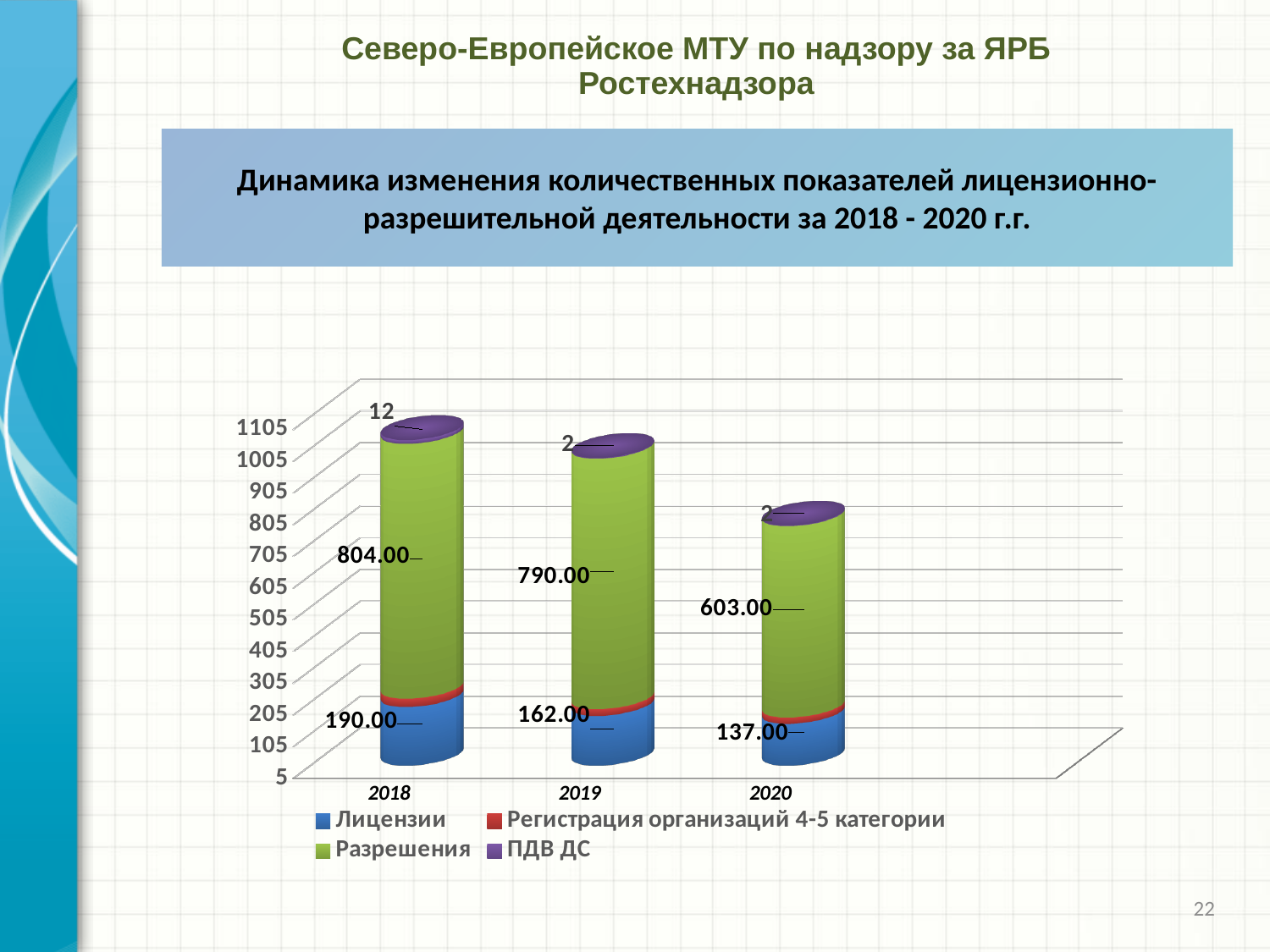
What is the difference between the Разрешения values for 2018 and 2020? 201.00 What is the value of Разрешения for 2019? 790.00 How many series does the legend list? 4 What is the value of Разрешения for 2020? 603.00 Which colour represents the Разрешения series? green In which year is the value of Разрешения highest? 2018 What is the value of ПДВ ДС for 2018? 12 What type of chart is shown on the slide? stacked bar chart Does the value of Лицензии rise or fall from 2018 to 2020? fall How many years are shown on the x axis? 3 In which year is the value of Лицензии lowest? 2020 What is the value of Лицензии for 2018? 190.00